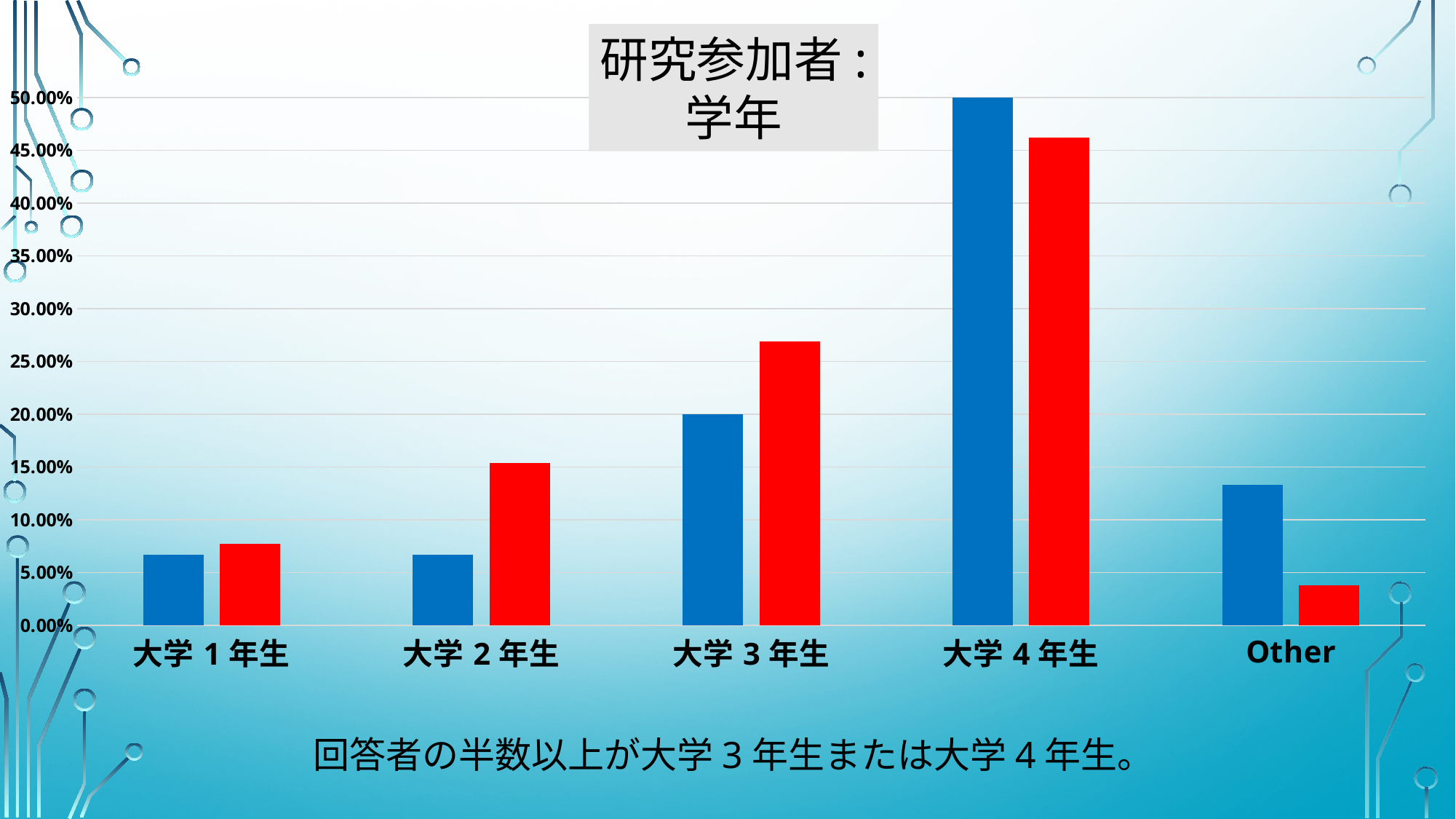
Which category has the tallest blue bar? 大学４年生 What is the title of the chart? 研究参加者：学年 For 大学２年生, which bar is taller, the blue one or the red one? the red one Is the red bar for Other greater or less than 5.00%? less Is the red bar for 大学３年生 greater or less than 25.00%? greater Which category has the tallest red bar? 大学４年生 How many categories are shown on the x axis? 5 What is the value of the blue bar for 大学３年生? 20.00% What kind of chart is shown on the slide? bar chart Which category has the shortest red bar? Other How many bars are shown for each category? 2